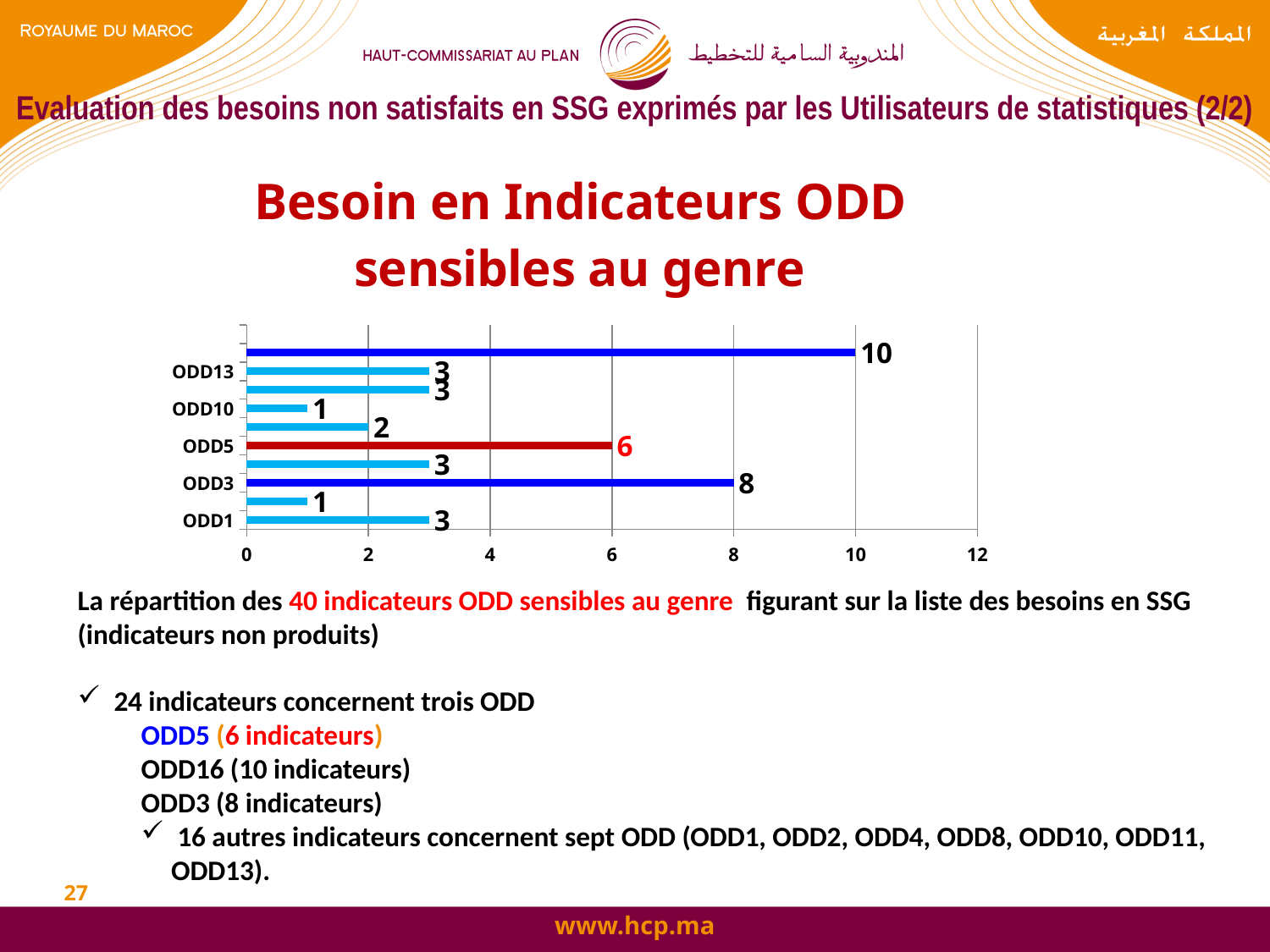
Which has a larger value, ODD3 or ODD5? ODD3 What is the value for ODD3? 8 What type of chart is shown on the slide? bar chart What is the value for ODD5? 6 What is the difference between the values for ODD3 and ODD5? 2 What is the lowest value shown by any bar in the chart? 1 What is the highest value shown by any bar in the chart? 10 What colour is the bar for ODD5? red How many bars are plotted in the chart? 10 What is the value for ODD13? 3 What is the value for ODD1? 3 What is the value for ODD10? 1